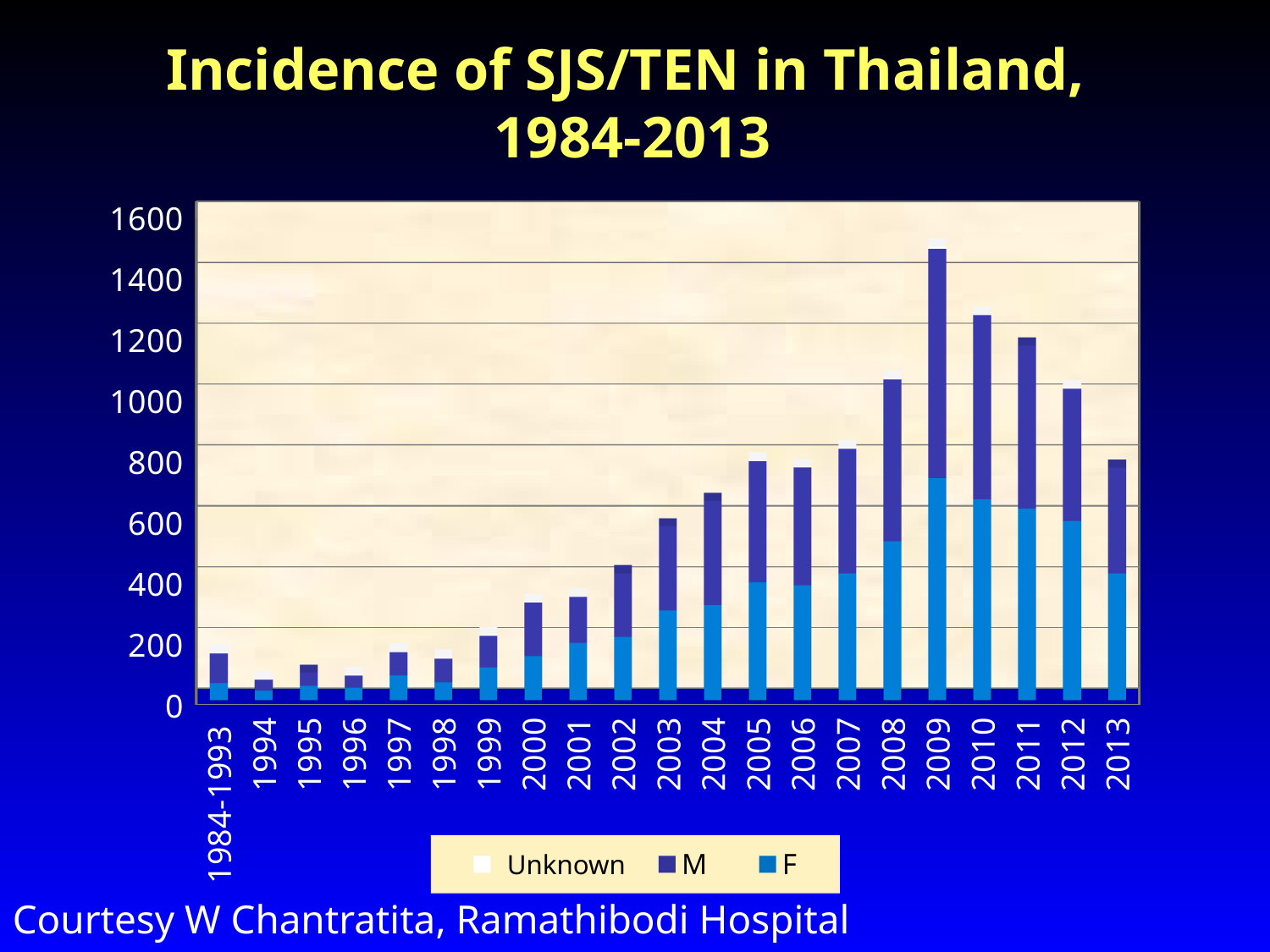
Is the total value for 2009 greater or less than 1400? greater Do the totals generally rise or fall from 1999 to 2009? rise Is the total value for 2013 greater or less than 1000? less Which has the larger total, 2002 or 2003? 2003 Which has the larger total, 2011 or 2012? 2011 How many categories are shown on the x axis? 21 Is the total value for 2008 greater or less than 1000? greater How many series does the legend list? 3 What kind of chart is shown on the slide? Stacked bar chart What is the title of the chart? Incidence of SJS/TEN in Thailand, 1984-2013 Which year has the highest total incidence? 2009